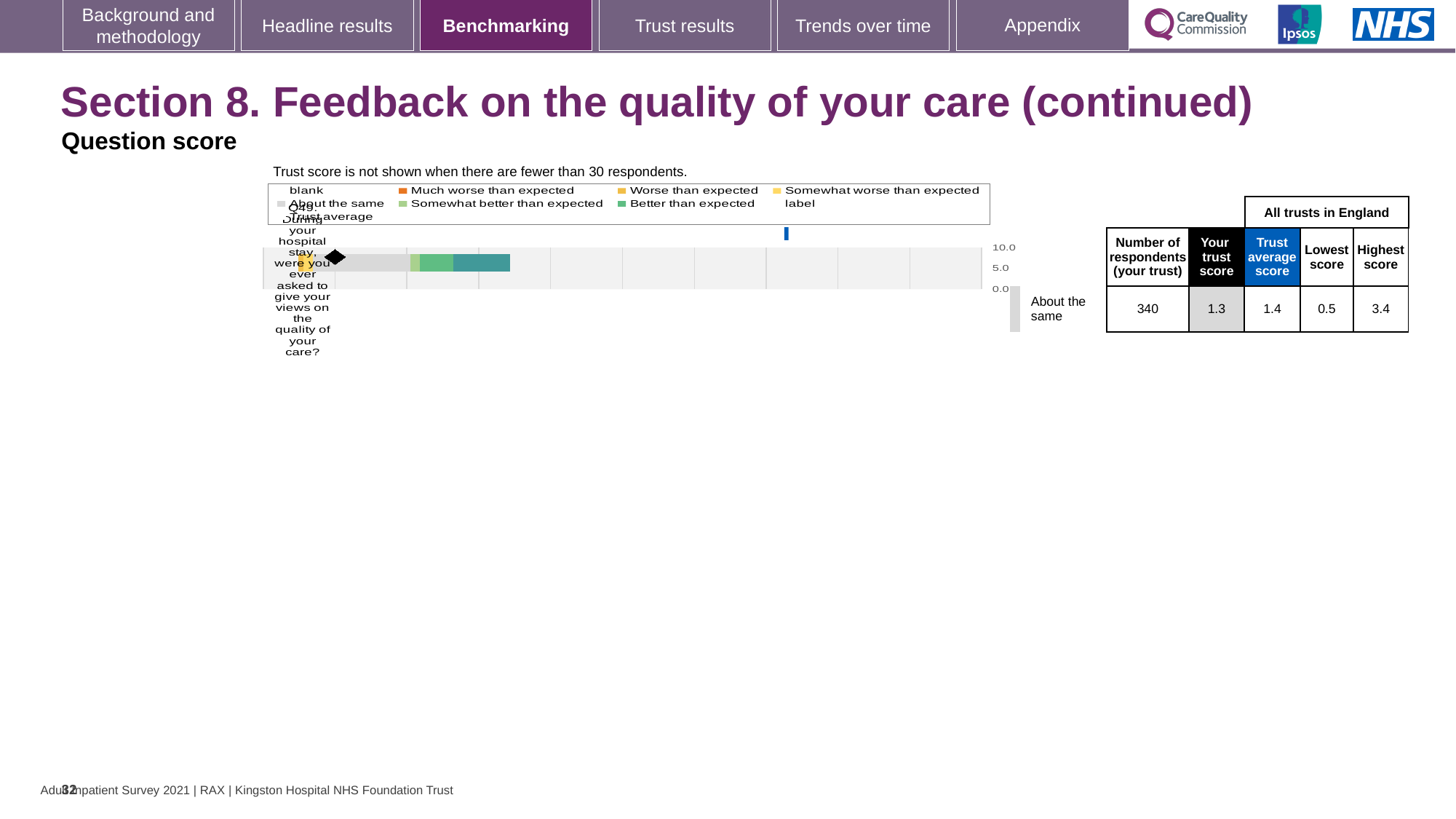
What is the lowest score among all trusts in England for Q49? 0.5 How many survey questions are plotted on the chart? 1 What is the trust average score for Q49 across all trusts in England? 1.4 Is the trust's score for Q49 greater or less than 5.0? less What is the difference between the highest and lowest scores for Q49 across all trusts in England? 2.9 Which is larger for Q49: the trust's score or the trust average score? Trust average score What is the highest score among all trusts in England for Q49? 3.4 What is the highest value shown on the chart's axis? 10.0 How many respondents from the trust answered Q49? 340 What benchmarking category is the trust's Q49 result placed in? About the same What is the trust's score for Q49 shown next to the chart? 1.3 What kind of chart is used to show the benchmarking result for Q49? bar chart